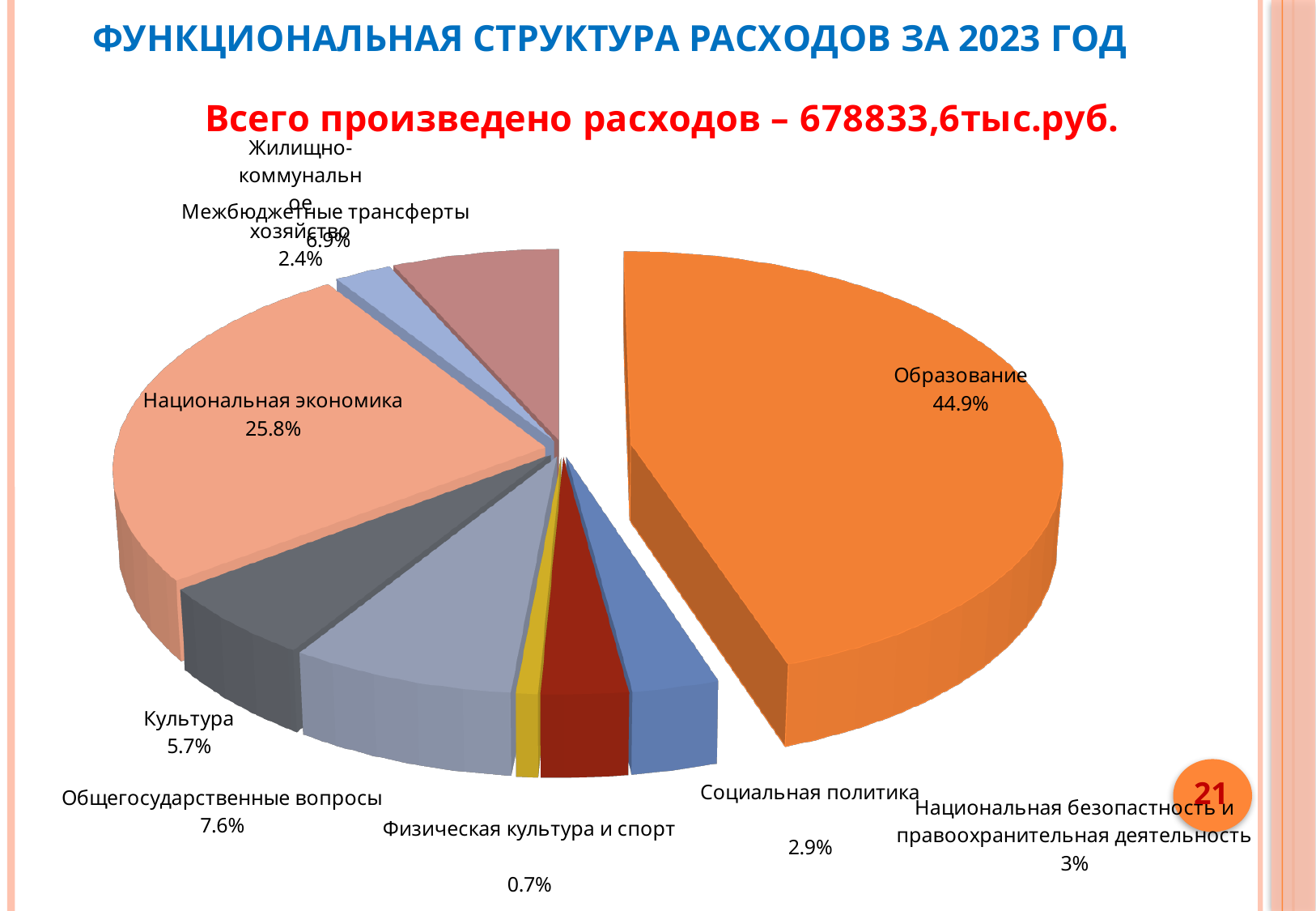
What share of expenditures does Образование account for? 44.9% What share of expenditures does Национальная экономика account for? 25.8% What share of expenditures does Физическая культура и спорт account for? 0.7% What share of expenditures does Культура account for? 5.7% Which has a larger share: Культура or Общегосударственные вопросы? Общегосударственные вопросы What is the total amount of expenditures stated on the slide? 678833,6тыс.руб. What is the difference in percentage points between Образование and Национальная экономика? 19.1 Which category has the largest share of expenditures? Образование What kind of chart is shown on the slide? pie chart Which category has the smallest share of expenditures? Физическая культура и спорт What share of expenditures does Социальная политика account for? 2.9% What share of expenditures does Общегосударственные вопросы account for? 7.6%